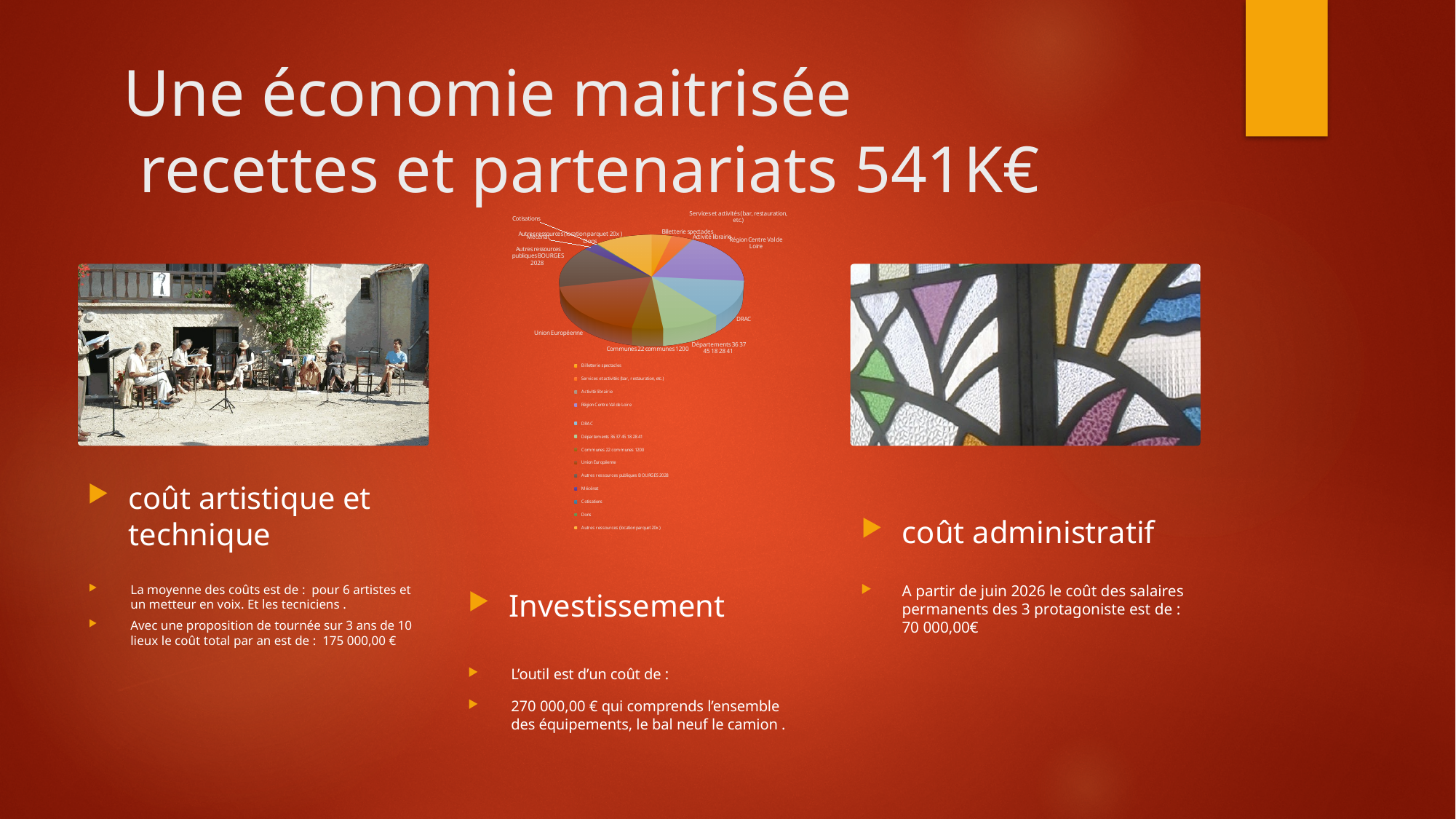
Which category is listed first in the pie chart's legend? Billetterie spectacles Which category is listed last in the pie chart's legend? Autres ressources (location parquet 20x) In the pie chart, is the slice for Région Centre Val de Loire larger or smaller than the slice for Cotisations? larger What kind of chart is shown on the slide? pie chart How many categories does the legend of the pie chart list? 13